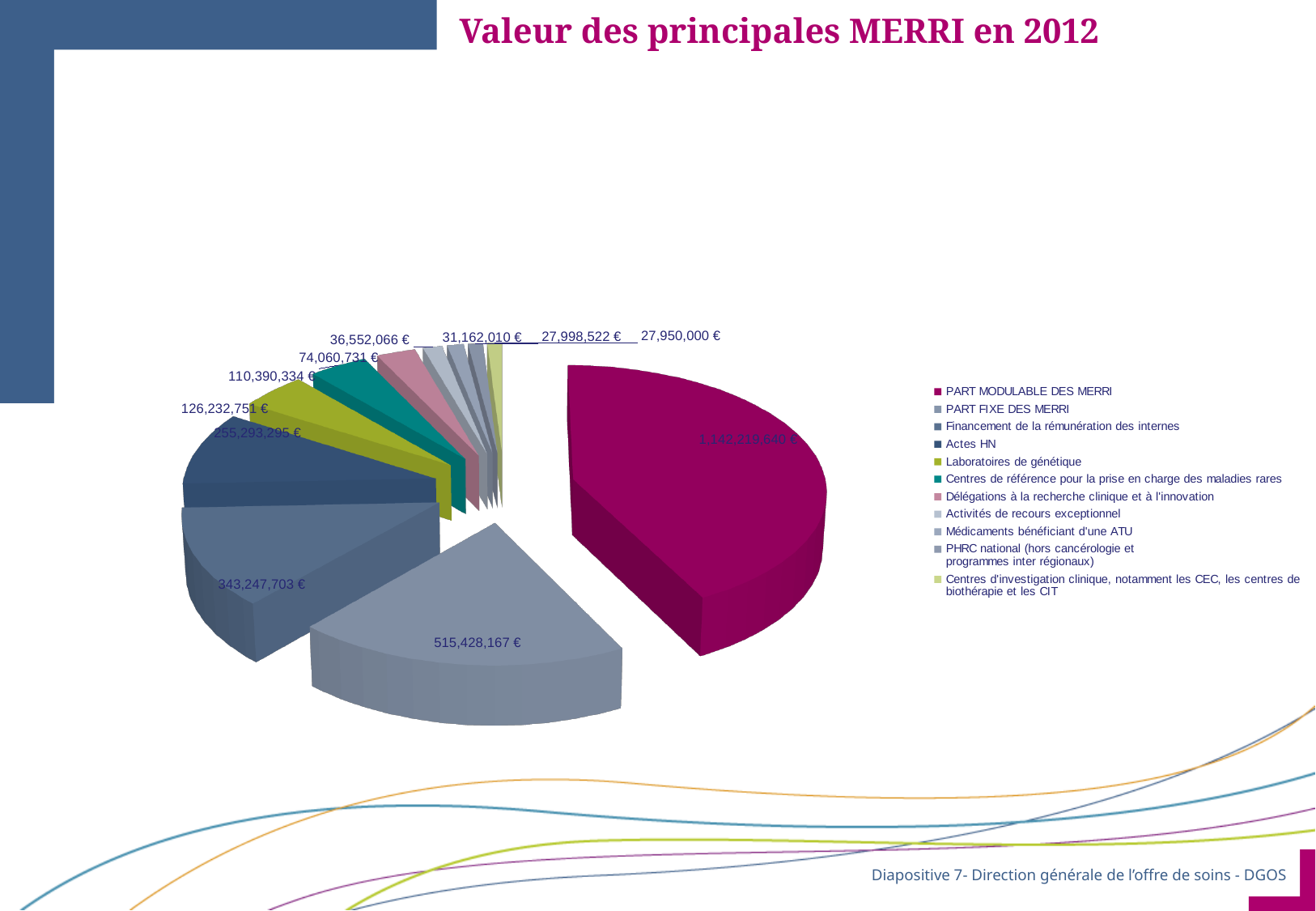
What is the value shown for Laboratoires de génétique? 126,232,751 € What kind of chart is shown on the slide? Pie chart What colour is the slice for PART MODULABLE DES MERRI? Magenta How many categories does the legend of the pie chart list? 11 Which category has the largest slice of the pie? PART MODULABLE DES MERRI What is the value shown for PART FIXE DES MERRI? 515,428,167 € What is the value shown for PART MODULABLE DES MERRI? 1,142,219,640 € What is the value shown for Financement de la rémunération des internes? 343,247,703 € What is the difference between the values for PART FIXE DES MERRI and Financement de la rémunération des internes? 172,180,464 € Which is larger, the value for PART FIXE DES MERRI or the value for Actes HN? PART FIXE DES MERRI What is the value shown for Actes HN? 255,293,295 € What is the title of the chart? Valeur des principales MERRI en 2012